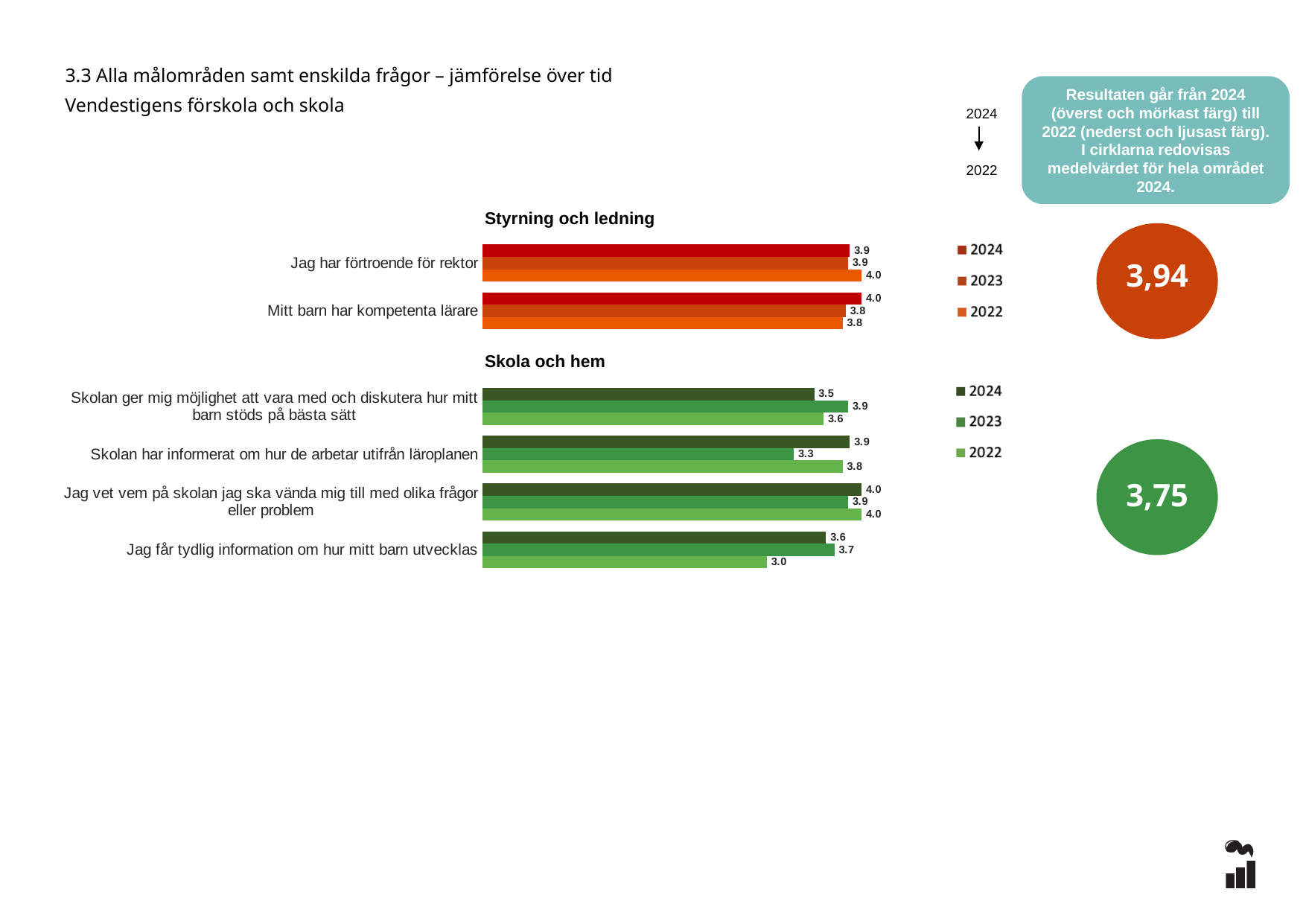
What type of chart is used for 'Styrning och ledning'? bar chart In the 'Skola och hem' chart, what is the 2023 value for 'Skolan har informerat om hur de arbetar utifrån läroplanen'? 3.3 What mean value is shown in the circle next to the 'Skola och hem' chart? 3,75 In the 'Skola och hem' chart, which question has the highest 2024 value? Jag vet vem på skolan jag ska vända mig till med olika frågor eller problem In the 'Skola och hem' chart, what is the 2022 value for 'Jag får tydlig information om hur mitt barn utvecklas'? 3.0 How many series does the legend of the 'Styrning och ledning' chart list? 3 How many questions (categories) are shown in the 'Skola och hem' chart? 4 In the 'Skola och hem' chart, what is the difference between the 2024 and 2023 values for 'Skolan har informerat om hur de arbetar utifrån läroplanen'? 0.6 In the 'Styrning och ledning' chart, what is the 2022 value for 'Jag har förtroende för rektor'? 4.0 In the 'Skola och hem' chart, is the 2023 value for 'Jag får tydlig information om hur mitt barn utvecklas' larger or smaller than its 2022 value? larger In the 'Styrning och ledning' chart, what is the 2024 value for 'Mitt barn har kompetenta lärare'? 4.0 In the 'Skola och hem' chart, which question has the lowest 2024 value? Skolan ger mig möjlighet att vara med och diskutera hur mitt barn stöds på bästa sätt